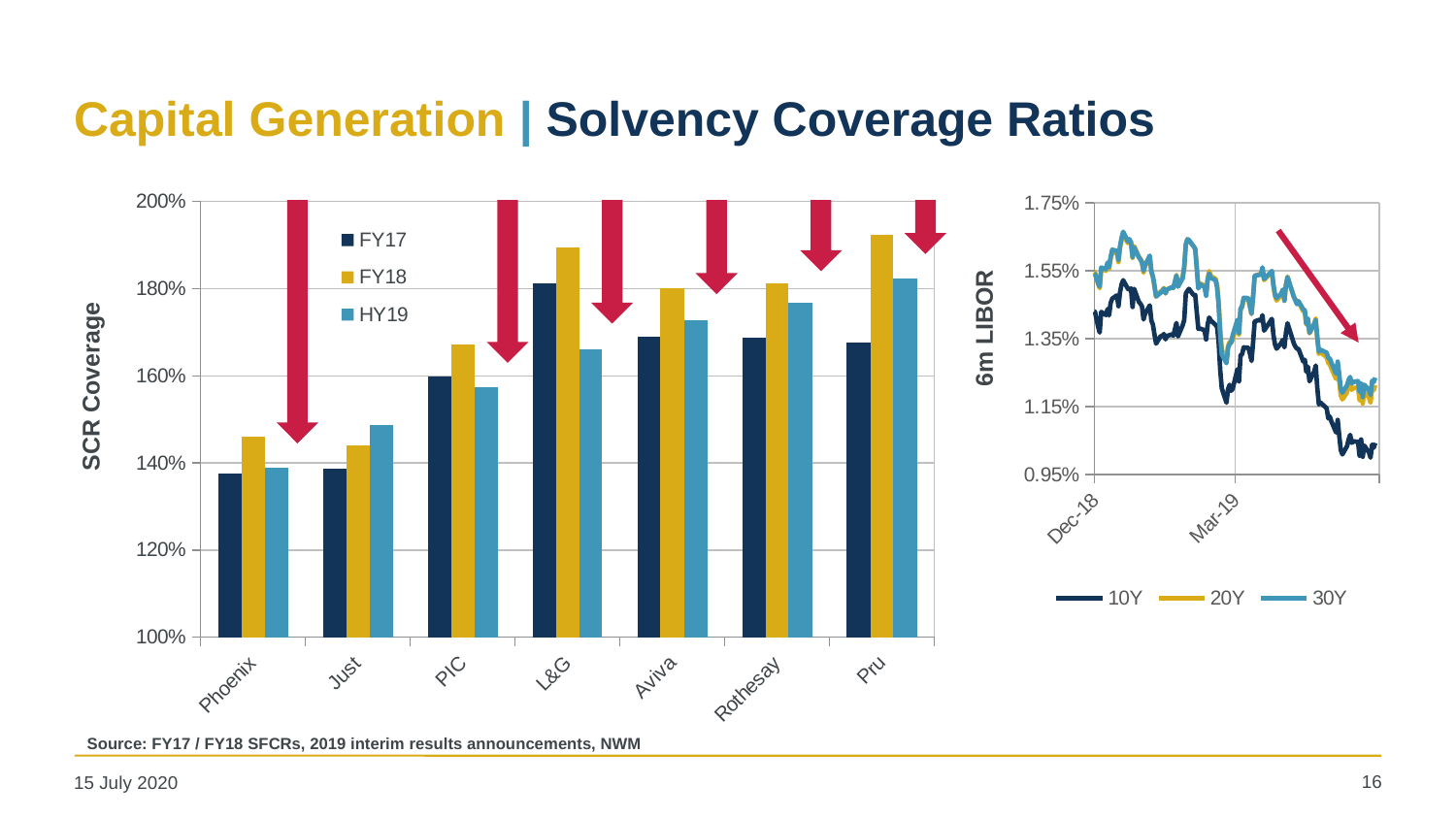
On the SCR Coverage chart, which company has the lowest HY19 value? Phoenix On the 6m LIBOR chart, do the values generally rise or fall from Dec-18 to the end of the period? fall On the SCR Coverage chart, is the HY19 value for PIC greater or less than 160%? less On the SCR Coverage chart, what kind of chart is it? bar chart On the SCR Coverage chart, how many companies are shown on the x axis? 7 On the SCR Coverage chart, how many series does the legend list? 3 On the 6m LIBOR chart, how many series does the legend list? 3 On the SCR Coverage chart, which is larger for L&G: the FY17 value or the HY19 value? FY17 On the SCR Coverage chart, which company has the highest HY19 value? Pru On the SCR Coverage chart, is the FY17 value for Phoenix greater or less than 140%? less On the 6m LIBOR chart, what kind of chart is it? line chart On the SCR Coverage chart, is the FY18 value for L&G greater or less than 180%? greater